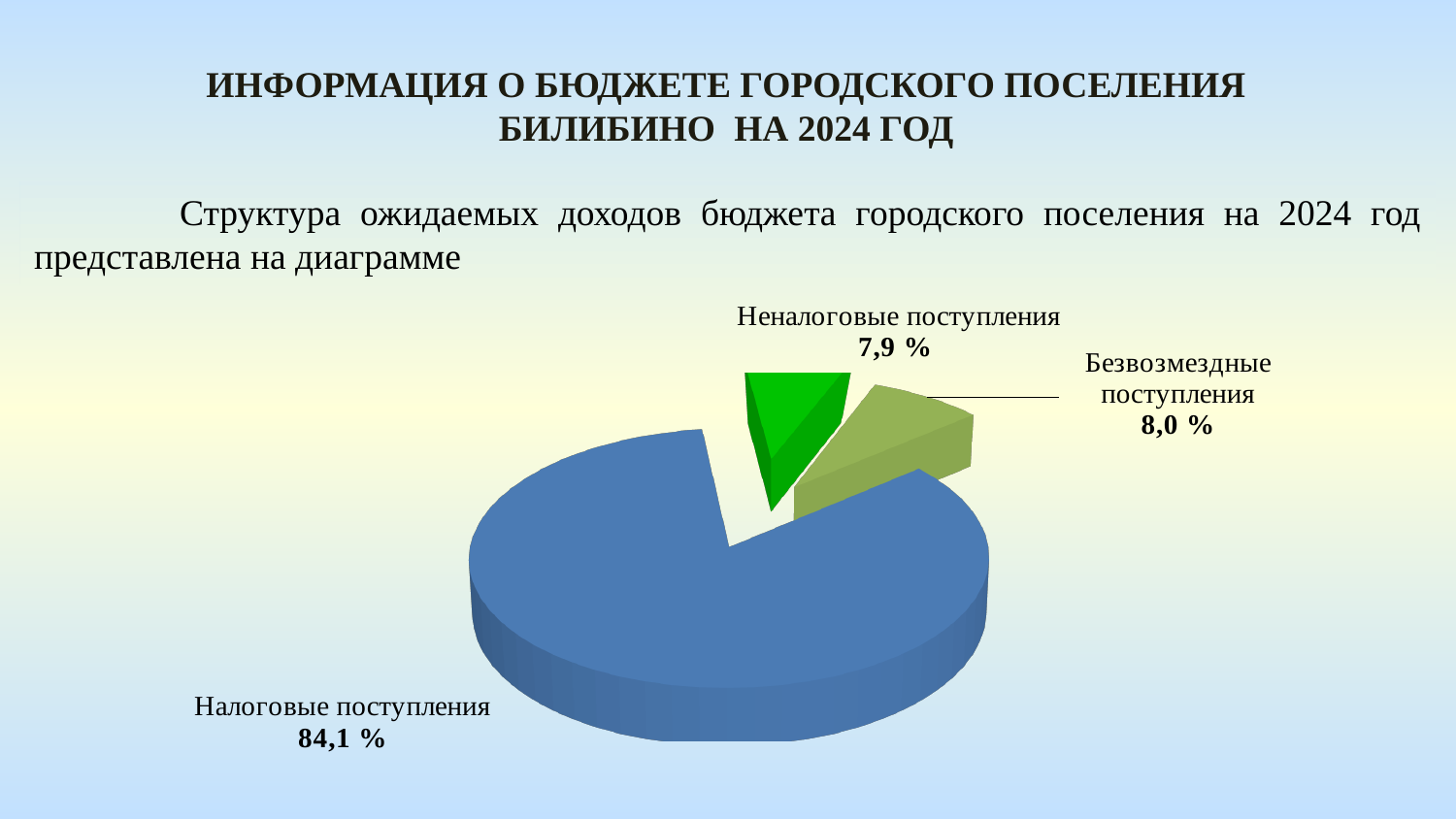
What colour is the slice for Неналоговые поступления? green How many slices does the pie chart have? 3 What share of the pie does Безвозмездные поступления have? 8,0 % Which category has the largest slice of the pie? Налоговые поступления What colour is the slice for Налоговые поступления? blue What is the difference between the shares of Налоговые поступления and Безвозмездные поступления? 76,1 % Which category has the smallest slice of the pie? Неналоговые поступления What share of the pie does Налоговые поступления have? 84,1 % Which is larger: the share of Налоговые поступления or the share of Неналоговые поступления? Налоговые поступления What kind of chart is shown on the slide? pie chart What is the difference between the shares of Безвозмездные поступления and Неналоговые поступления? 0,1 % What share of the pie does Неналоговые поступления have? 7,9 %